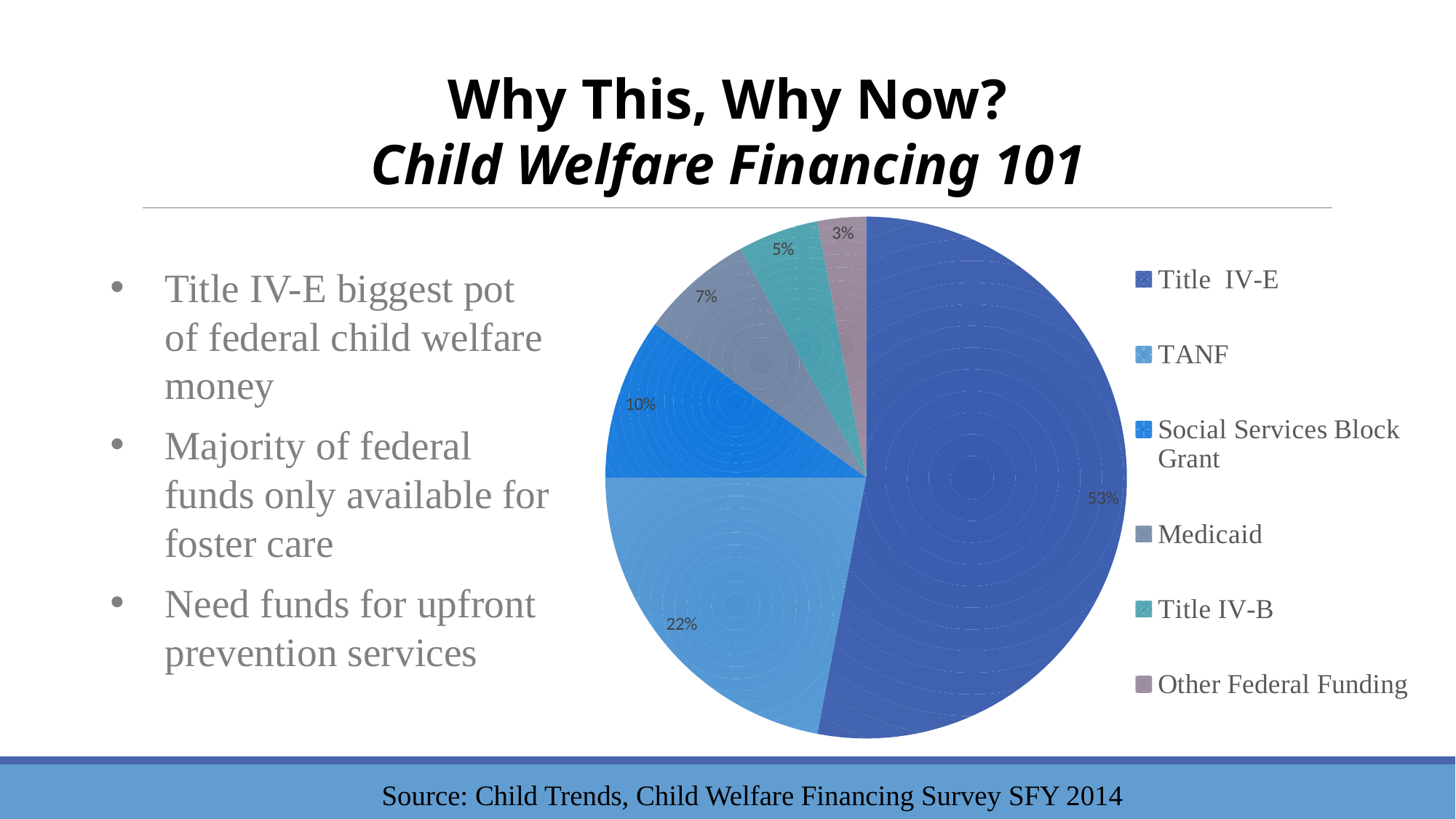
What percentage is shown for TANF? 22% What kind of chart is shown on the slide? Pie chart What share of the pie does Title IV-E represent? 53% What percentage does Medicaid account for? 7% Which is larger, Medicaid or Title IV-B? Medicaid How many categories does the legend list? 6 What is the value for Social Services Block Grant? 10% Which category has the smallest slice of the pie? Other Federal Funding What share is labelled for Other Federal Funding? 3% What is the value shown for Title IV-B? 5% Which category has the largest slice of the pie? Title IV-E What is the difference in percentage points between Title IV-E and TANF? 31